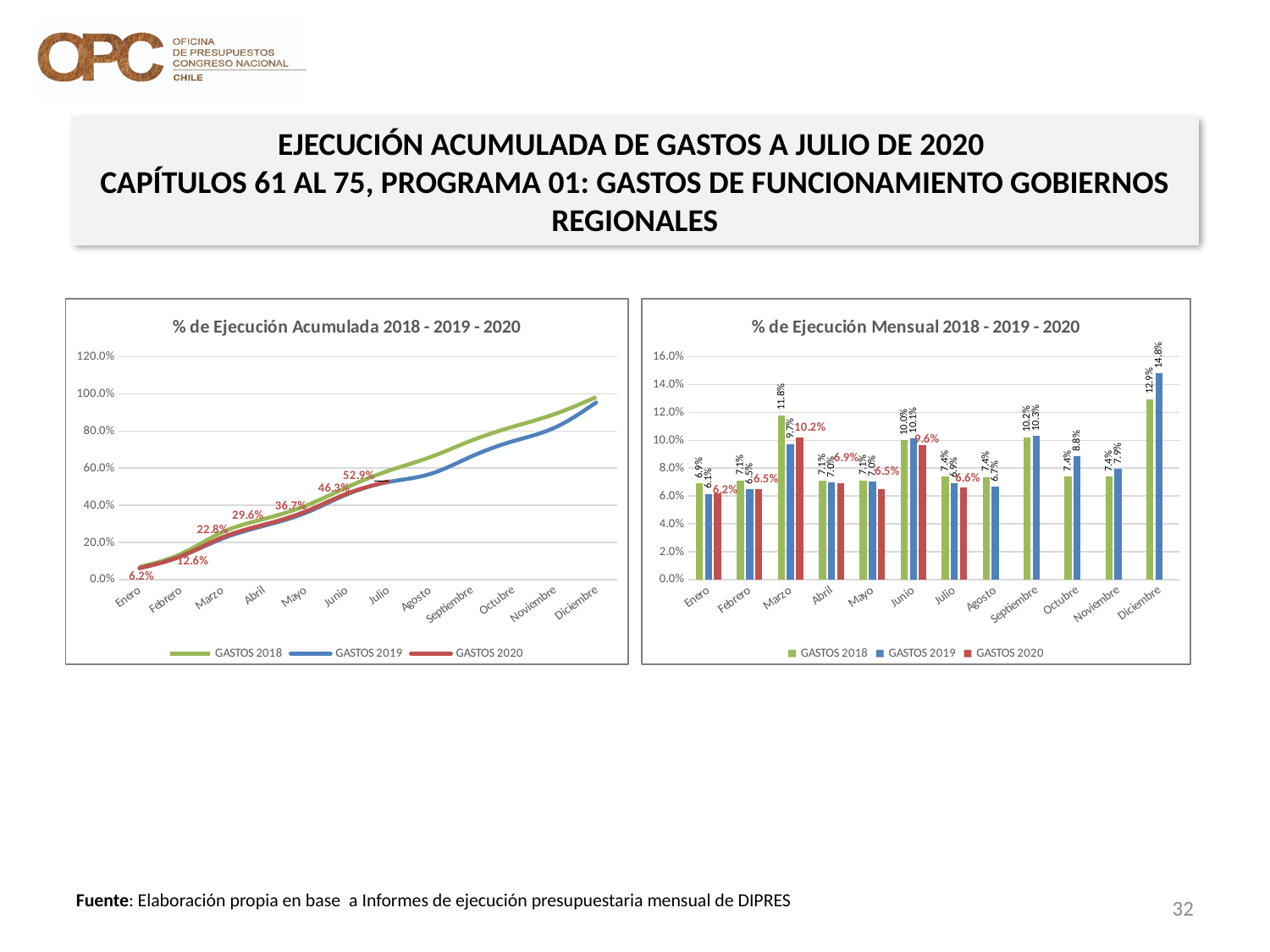
What kind of chart is the left chart titled '% de Ejecución Acumulada 2018 - 2019 - 2020'? Line chart In the left chart (% de Ejecución Acumulada), what is the GASTOS 2020 value for Julio? 52.9% In the right chart (% de Ejecución Mensual), what is the difference between the GASTOS 2019 and GASTOS 2018 values for Diciembre? 1.9 percentage points How many months are shown on the x axis of the left chart (% de Ejecución Acumulada)? 12 What kind of chart is the right chart titled '% de Ejecución Mensual 2018 - 2019 - 2020'? Bar chart In the left chart (% de Ejecución Acumulada), what is the GASTOS 2020 value for Marzo? 22.8% In the right chart (% de Ejecución Mensual), what is the GASTOS 2019 value for Diciembre? 14.8% In the right chart (% de Ejecución Mensual), which month has the highest GASTOS 2020 value? Marzo In the right chart (% de Ejecución Mensual), which is larger for Marzo: GASTOS 2018 or GASTOS 2019? GASTOS 2018 How many series does the legend of the right chart (% de Ejecución Mensual) list? 3 In the left chart (% de Ejecución Acumulada), does the GASTOS 2020 line rise or fall from Enero to Julio? Rise In the right chart (% de Ejecución Mensual), what is the GASTOS 2018 value for Marzo? 11.8%